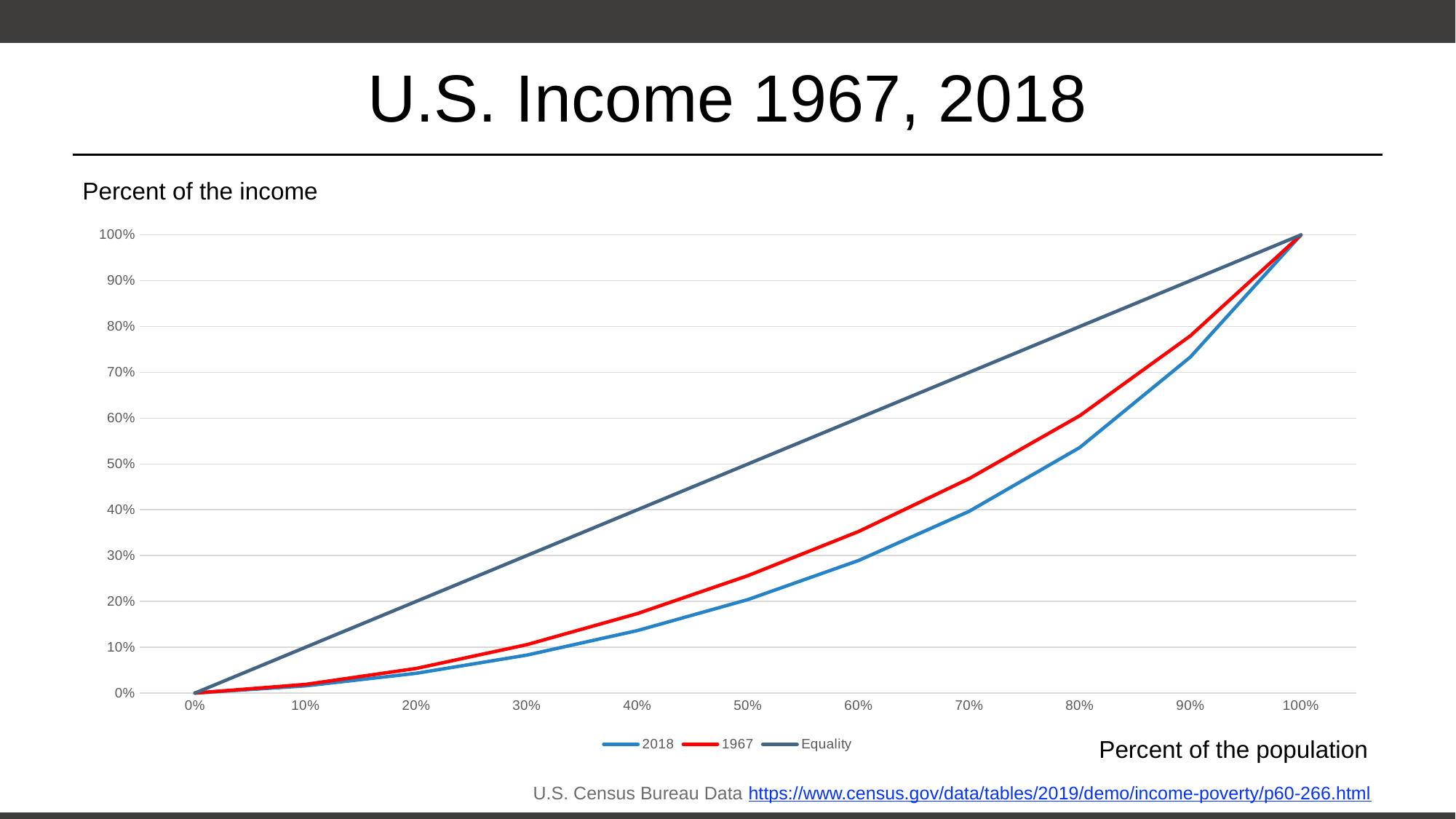
Do the values of the 2018 line rise or fall as the percent of the population increases? rise At 80% of the population, which series has the larger value, 1967 or 2018? 1967 Is the value for 2018 at 50% of the population greater or less than 30%? less What is the value of the 1967 line at 0% of the population? 0% What is the value of the Equality line at 50% of the population? 50% What kind of chart is shown on the slide? line chart How many tick labels are shown on the x axis (Percent of the population)? 11 Is the value for 2018 at 80% of the population greater or less than 50%? greater What are the names of the series in the legend? 2018, 1967, Equality What is the value of the 2018 line at 100% of the population? 100% Is the value for 1967 at 70% of the population greater or less than 50%? less How many series does the legend list? 3